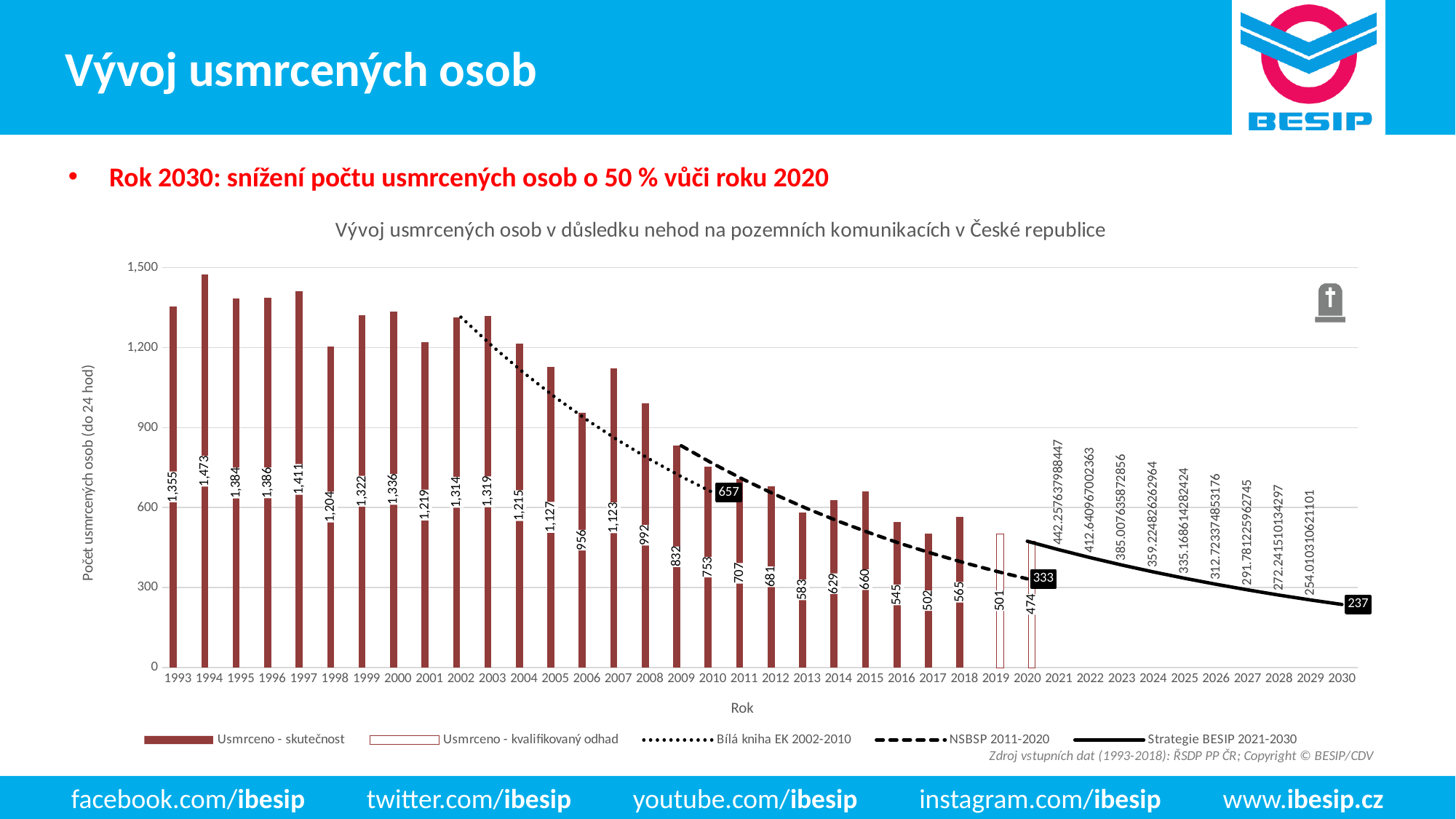
What is the value of the 'Usmrceno - kvalifikovaný odhad' bar for 2020? 474 What is the difference between the values for 2009 and 2010? 79 What kind of chart is used to show the 'Usmrceno - skutečnost' data? bar chart Which year has the highest bar in the chart? 1994 Is the value for 2016 greater or less than 600? less What value does the 'NSBSP 2011-2020' dashed line end at in 2020? 333 What is the number of persons killed shown for 1994? 1,473 Which year has the lowest bar in the chart? 2020 What value does the 'Strategie BESIP 2021-2030' line reach in 2030? 237 Which year has the larger value, 2006 or 2007? 2007 How many series does the legend list? 5 Do the bar values generally rise or fall from 2003 to 2020? fall